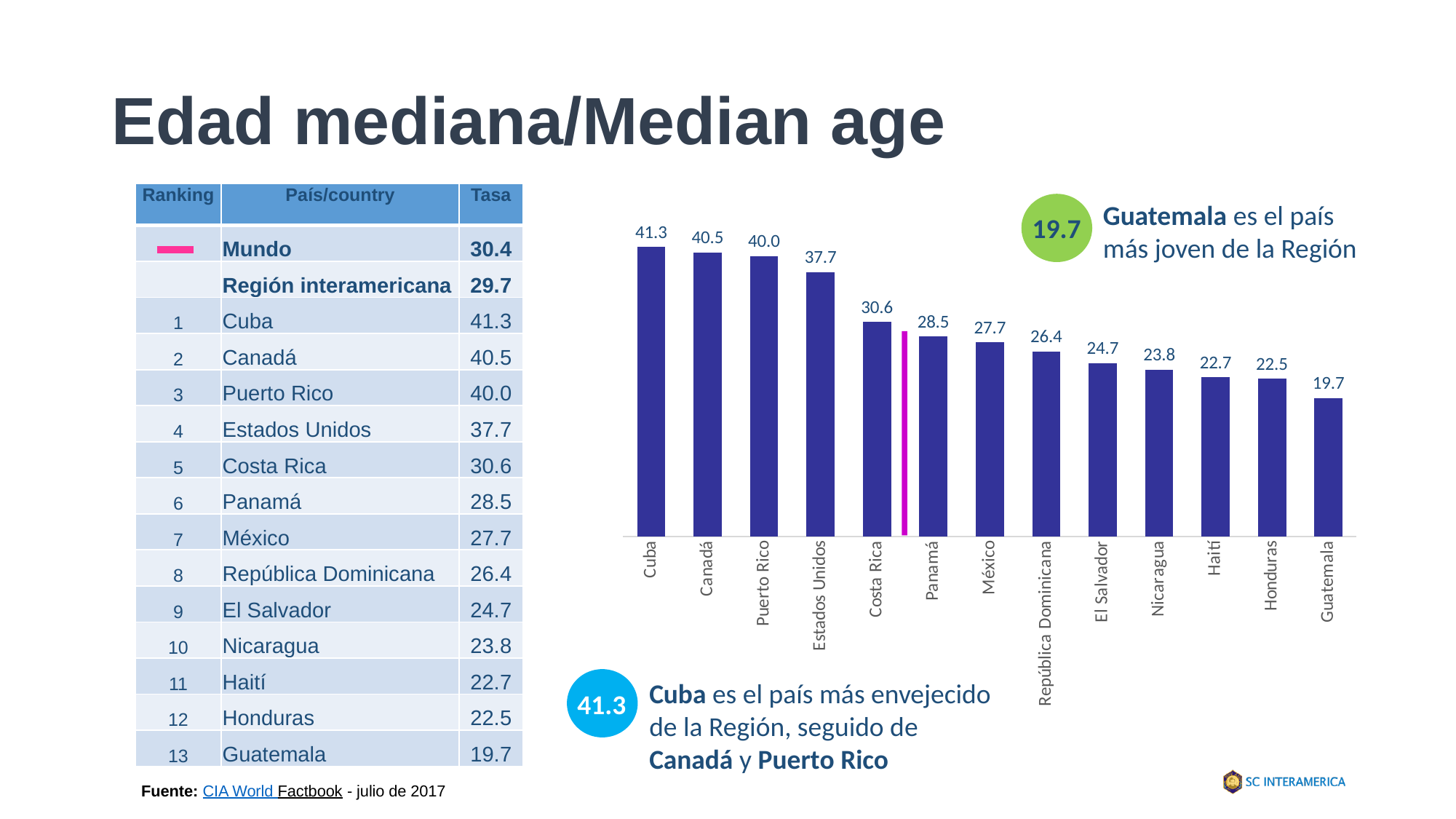
What is the difference between the median age of Canadá and Puerto Rico in the bar chart? 0.5 Do the values in the bar chart rise or fall from left to right? Fall Which country has the lowest median age in the bar chart? Guatemala Which country has the highest median age in the bar chart? Cuba Which has a higher median age in the bar chart, Panamá or México? Panamá What is the median age shown for Cuba in the bar chart? 41.3 What type of chart is used to show the median ages? Bar chart What is the median age shown for Haití in the bar chart? 22.7 What is the difference between the median age of Cuba and Guatemala in the bar chart? 21.6 What is the median age shown for Guatemala in the bar chart? 19.7 What is the median age shown for Estados Unidos in the bar chart? 37.7 How many countries are plotted in the bar chart? 13